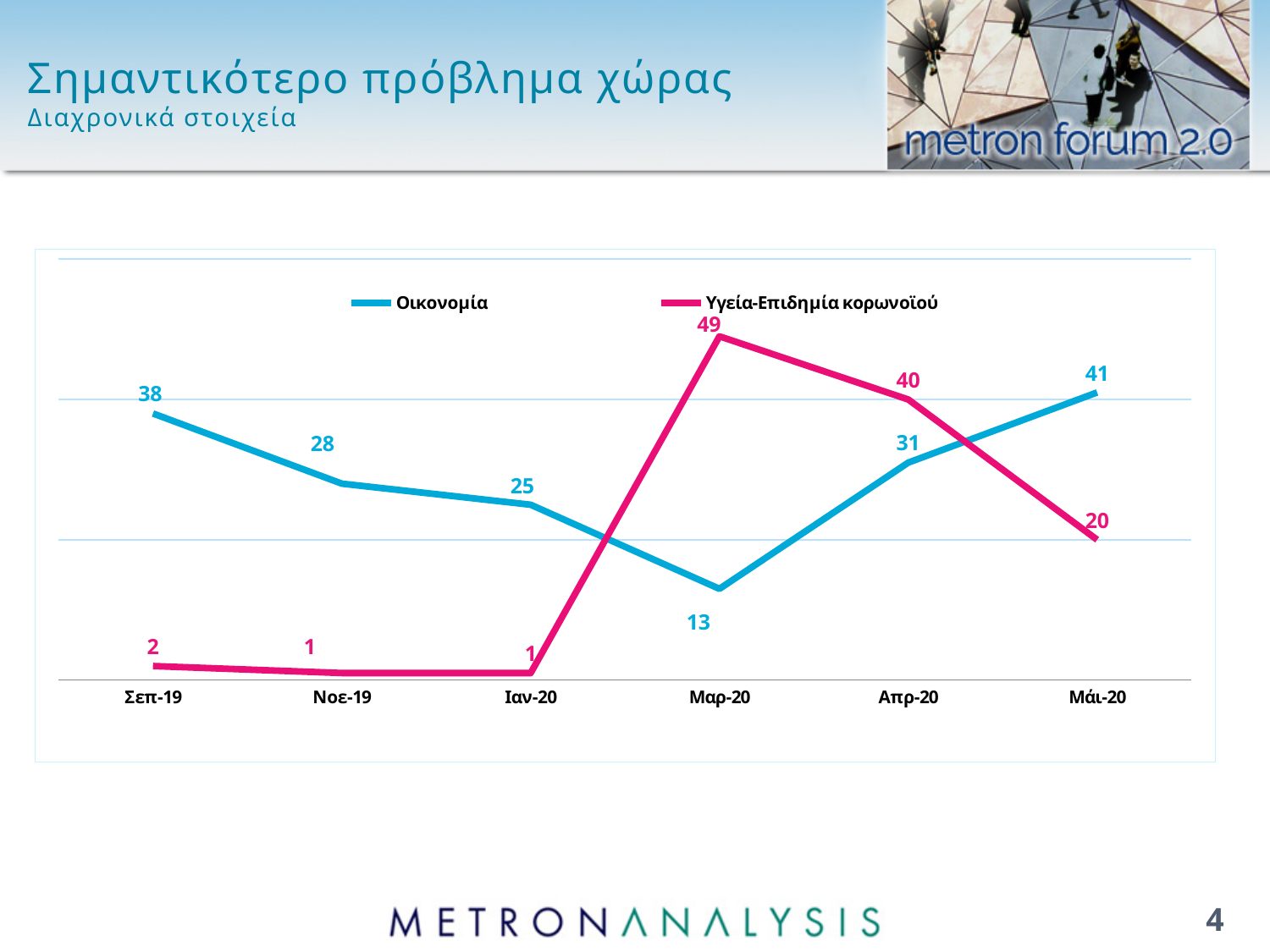
How many series does the legend list? 2 How many time points are plotted along the x axis? 6 What kind of chart is shown on the slide? Line chart How does the Οικονομία series change from Σεπ-19 to Μαρ-20? It falls Which colour is used for the Οικονομία series? Blue At which time point is the Υγεία-Επιδημία κορωνοϊού series highest? Μαρ-20 What is the value for Οικονομία at Μάι-20? 41 At Απρ-20, which series has the larger value, Οικονομία or Υγεία-Επιδημία κορωνοϊού? Υγεία-Επιδημία κορωνοϊού At which time point is the Οικονομία series lowest? Μαρ-20 What is the value for Οικονομία at Σεπ-19? 38 What is the difference between Υγεία-Επιδημία κορωνοϊού and Οικονομία at Μαρ-20? 36 What is the value for Υγεία-Επιδημία κορωνοϊού at Μαρ-20? 49